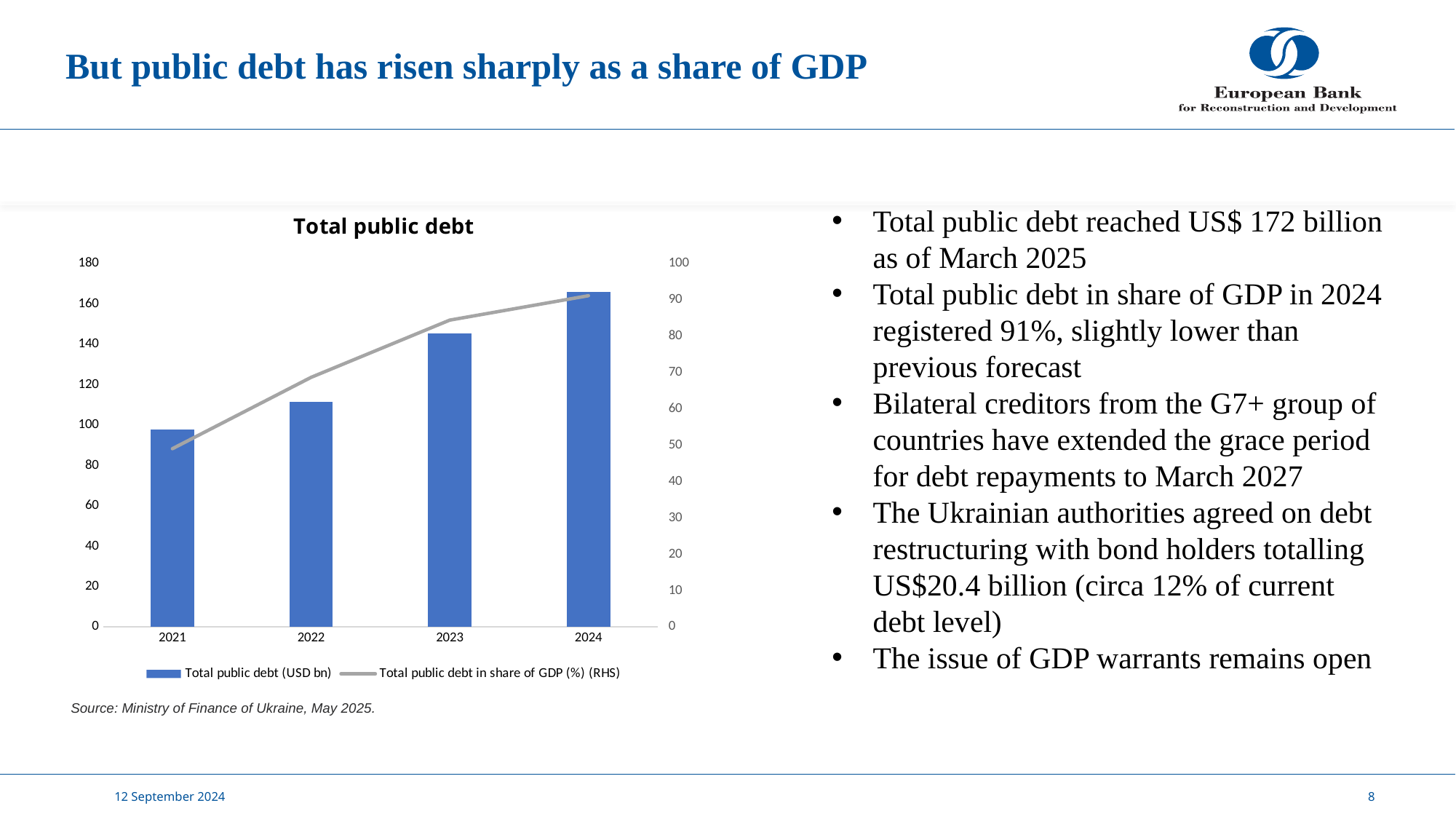
What is the title of the chart on the slide? Total public debt Is the Total public debt (USD bn) bar for 2024 greater or less than 140? greater Which series in the chart is plotted on the right-hand axis (RHS)? Total public debt in share of GDP (%) Do the Total public debt (USD bn) bars rise or fall from 2021 to 2024? rise Which year has the lowest bar for Total public debt (USD bn)? 2021 Is the Total public debt in share of GDP (%) value for 2021 greater or less than 60? less How many years are shown on the x axis of the chart? 4 Is the Total public debt (USD bn) bar for 2022 greater or less than 100? greater Which year has the larger Total public debt (USD bn) bar, 2022 or 2023? 2023 Which year has the highest bar for Total public debt (USD bn)? 2024 How many series does the chart's legend list? 2